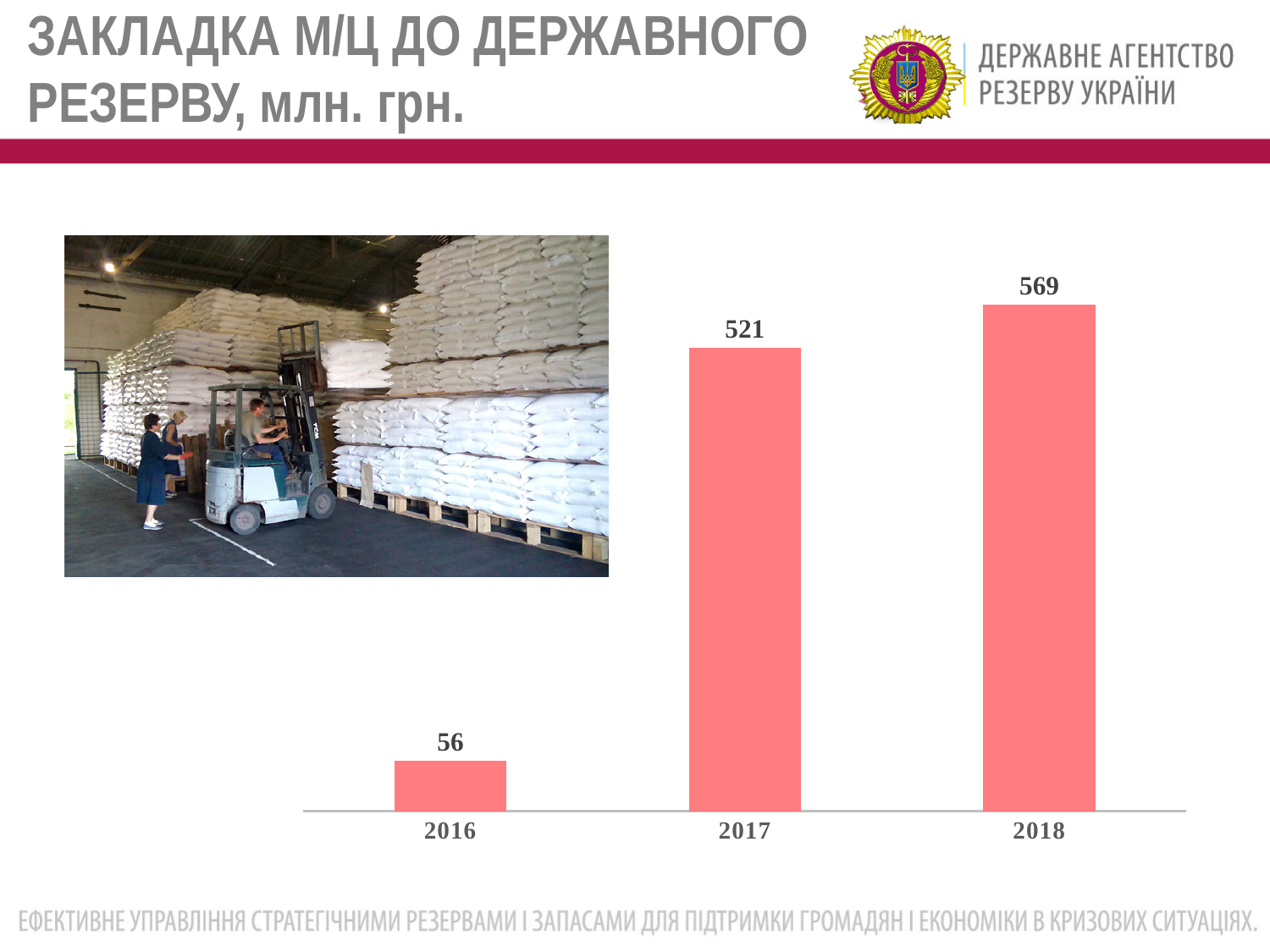
What kind of chart is shown on the slide? bar chart What is the difference between the values for 2017 and 2016? 465 What is the value for 2017? 521 How many years are shown on the chart? 3 Which is larger, the value for 2017 or the value for 2018? 2018 Which year has the lowest value? 2016 What unit is given in the slide title for the chart values? млн. грн. What is the difference between the values for 2018 and 2017? 48 Which year has the highest value? 2018 What is the value for 2016? 56 Do the values rise or fall from 2016 to 2018? rise What is the value for 2018? 569